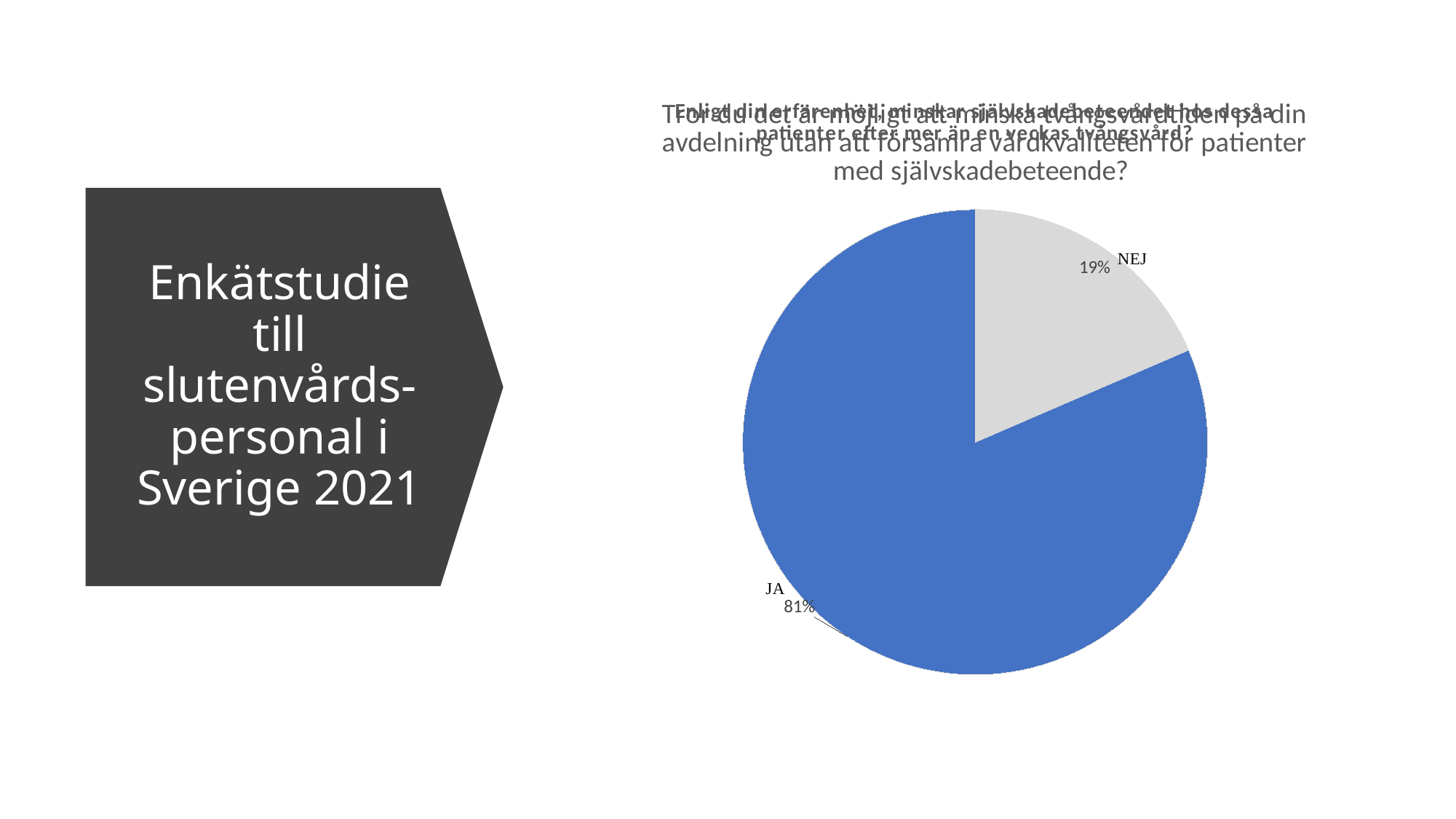
Which is larger, the JA slice or the NEJ slice? JA What share of the pie does the NEJ slice represent? 19% What percentage of the pie chart is labelled NEJ? 19% Which slice of the pie chart is the smallest? NEJ How many slices does the pie chart have? 2 What kind of chart is shown on the slide? Pie chart What colour is the JA slice in the pie chart? Blue What is the difference in percentage points between the JA and NEJ slices? 62 What colour is the NEJ slice in the pie chart? Grey Which slice of the pie chart is the largest? JA What percentage of the pie chart is labelled JA? 81%